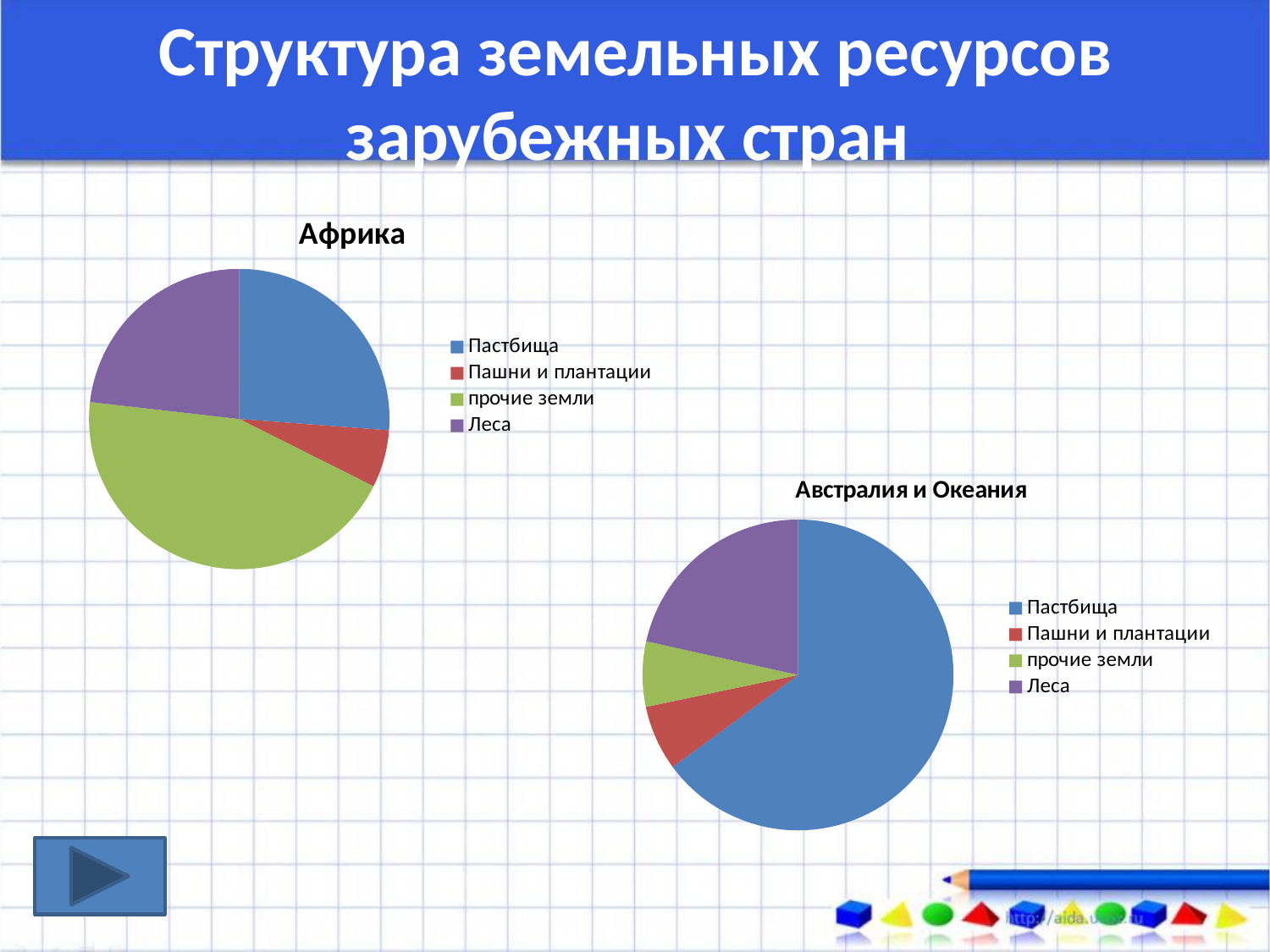
How many categories does the "Африка" chart legend list? 4 How many categories does the "Австралия и Океания" chart legend list? 4 In the "Австралия и Океания" chart, which slice is larger: Леса or прочие земли? Леса What kind of chart is the "Африка" chart? pie chart In the "Австралия и Океания" chart, which category has the largest slice? Пастбища In the "Африка" chart, which slice is larger: прочие земли or Пашни и плантации? прочие земли What is the title of the slide containing the two pie charts? Структура земельных ресурсов зарубежных стран In the "Африка" chart, which category has the smallest slice? Пашни и плантации In the "Африка" chart, which category has the largest slice? прочие земли What kind of chart is the "Австралия и Океания" chart? pie chart In the "Африка" chart, what colour represents Леса? purple In the "Австралия и Океания" chart, which slice is larger: Пастбища or Леса? Пастбища